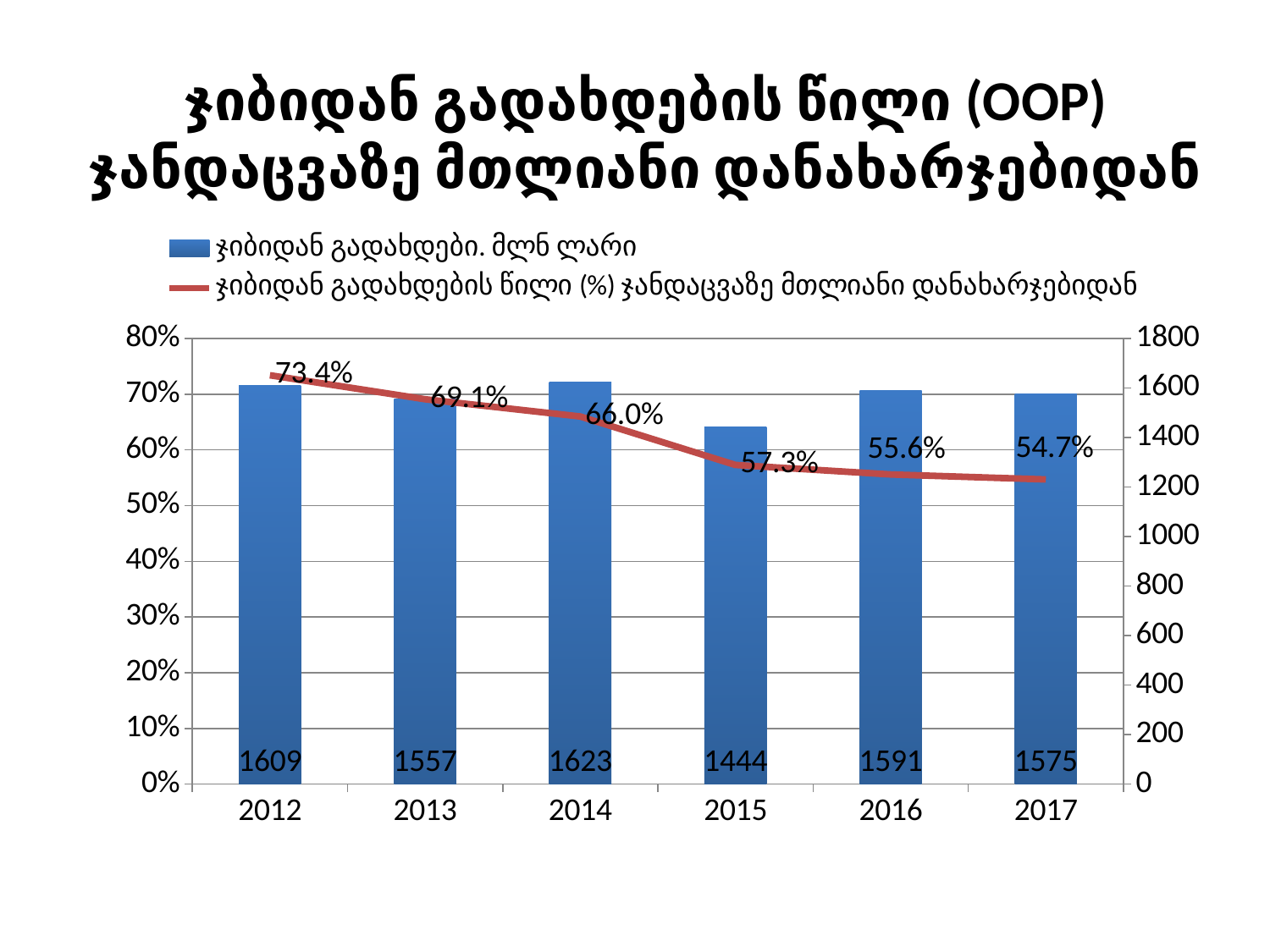
What is the out-of-pocket share (%) shown on the line for 2017? 54.7% Which year has the highest out-of-pocket payments bar (მლნ ლარი)? 2014 Does the out-of-pocket share (%) line rise or fall from 2012 to 2017? fall How many series does the legend list? 2 What is the value of the out-of-pocket payments bar (ჯიბიდან გადახდები, მლნ ლარი) for 2015? 1444 What is the difference between the out-of-pocket payments bars for 2014 and 2015? 179 What is the out-of-pocket share (%) shown on the line for 2012? 73.4% Which is larger, the out-of-pocket payments bar for 2016 or for 2017? 2016 What is the difference between the out-of-pocket share in 2012 and in 2017? 18.7% Which year has the lowest out-of-pocket payments bar (მლნ ლარი)? 2015 How many years are shown on the x axis of the chart? 6 What colour is the line showing the out-of-pocket share (%)? red